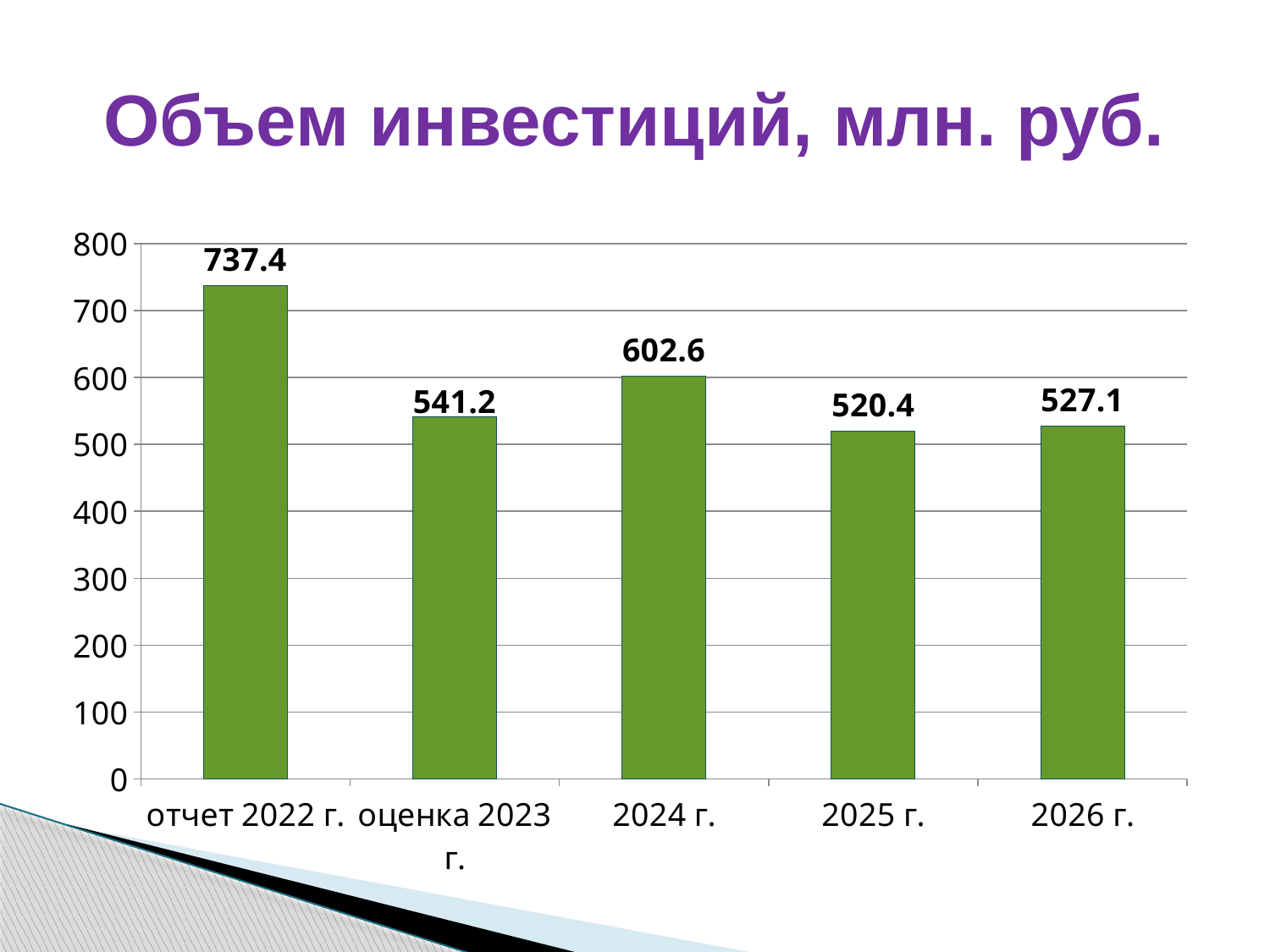
How many categories are shown on the x axis? 5 Is the value for 2025 г. greater or less than 600? less What is the difference between the values for 2024 г. and 2025 г.? 82.2 Which category has the highest value? отчет 2022 г. What is the value for 2026 г.? 527.1 What is the value for 2024 г.? 602.6 Which is larger, the value for оценка 2023 г. or the value for 2024 г.? 2024 г. What is the value for отчет 2022 г.? 737.4 What kind of chart is shown on the slide? bar chart What is the title of the chart? Объем инвестиций, млн. руб. Which category has the lowest value? 2025 г. What is the difference between the values for отчет 2022 г. and оценка 2023 г.? 196.2